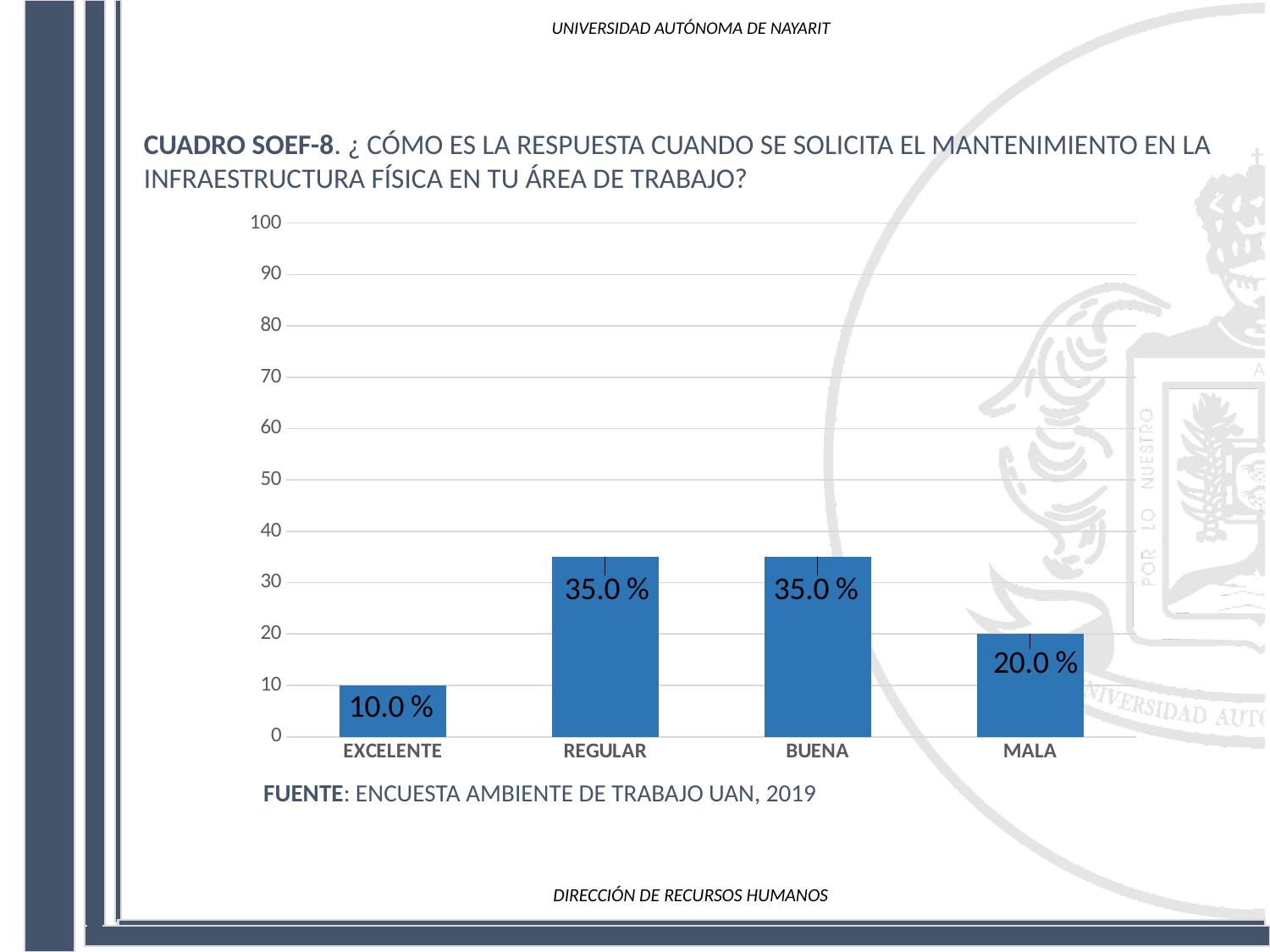
Is the value for BUENA greater or less than 30? greater What is the source cited below the chart? ENCUESTA AMBIENTE DE TRABAJO UAN, 2019 Which category has the lowest value? EXCELENTE Which is larger, the value for MALA or the value for EXCELENTE? MALA What kind of chart is shown on the slide? bar chart What is the value for MALA? 20.0 % What is the difference between the values for BUENA and MALA? 15.0 % How many categories are shown on the x axis? 4 What is the value for EXCELENTE? 10.0 % What is the value for REGULAR? 35.0 % What is the highest value shown on the y axis? 100 What is the difference between the values for MALA and EXCELENTE? 10.0 %